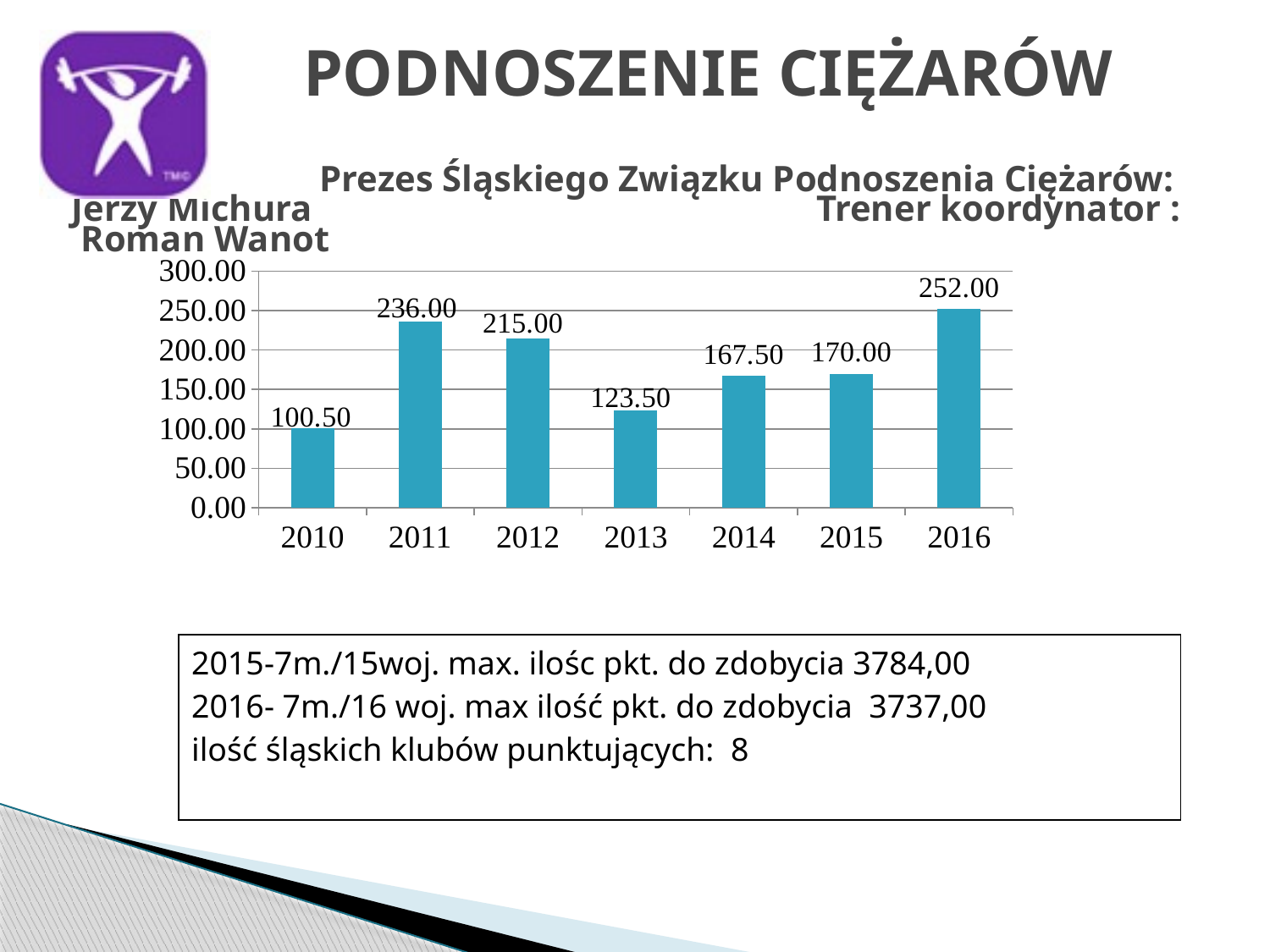
What is the difference between the values for 2016 and 2015? 82.00 Which year has the lowest value? 2010 What is the difference between the values for 2011 and 2012? 21.00 Do the values rise or fall from 2013 to 2016? rise What kind of chart is shown on the slide? bar chart Is the value for 2012 greater or less than 200.00? greater What is the value for 2010? 100.50 What is the value for 2016? 252.00 How many years are shown on the x axis? 7 What is the value for 2013? 123.50 Which is larger, the value for 2014 or the value for 2013? 2014 Which year has the highest value? 2016